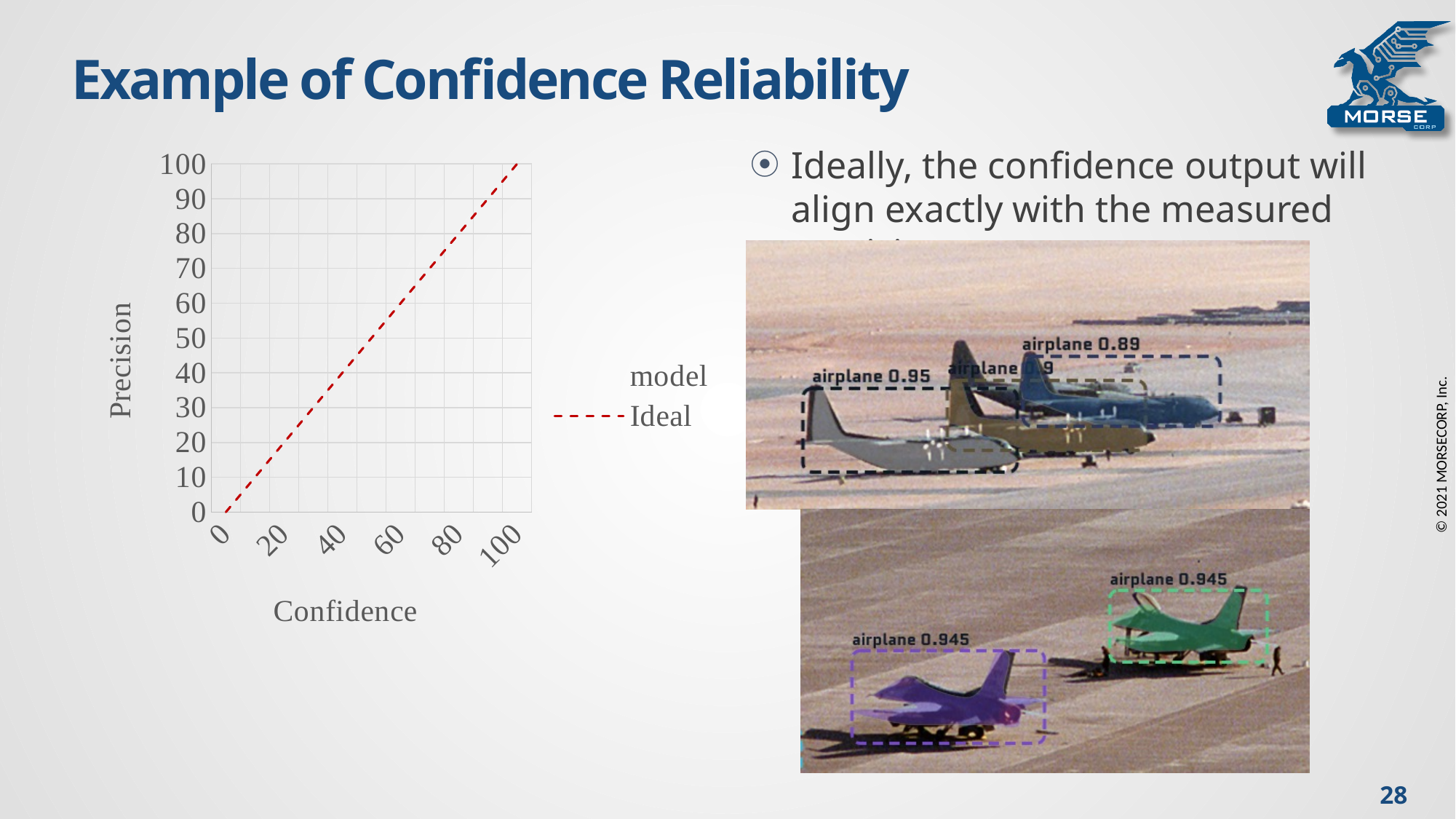
What kind of chart is shown on the slide? line chart Is the Precision of the Ideal line at a Confidence of 80 greater or less than 50? greater What Precision value does the Ideal line reach at a Confidence of 100? 100 Is the Precision of the Ideal line at a Confidence of 20 greater or less than 50? less What is the label of the chart's x axis? Confidence Which legend entry is drawn as a red dashed line? Ideal What is the highest value shown on the chart's y axis? 100 How many series does the chart's legend list? 2 What Precision value does the Ideal line have at a Confidence of 0? 0 Does the Ideal line rise or fall as Confidence increases? rise What is the label of the chart's y axis? Precision